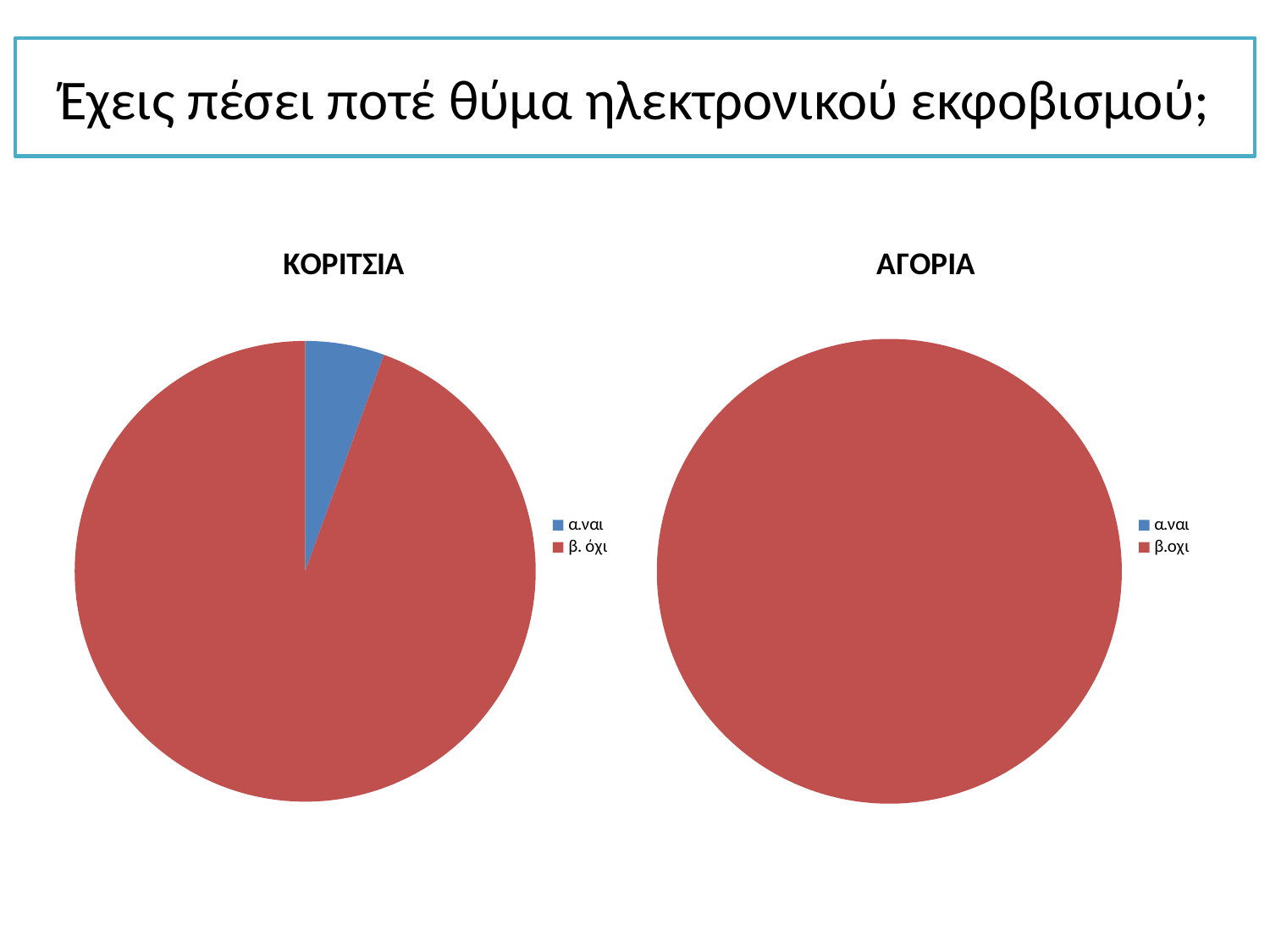
Which chart shows a visible α.ναι slice, ΚΟΡΙΤΣΙΑ or ΑΓΟΡΙΑ? ΚΟΡΙΤΣΙΑ In the ΚΟΡΙΤΣΙΑ chart, which category has the smallest slice? α.ναι In the ΚΟΡΙΤΣΙΑ chart, which category has the largest slice? β. όχι What is the title of the chart on the left? ΚΟΡΙΤΣΙΑ In the ΑΓΟΡΙΑ chart, which is larger: α.ναι or β.οχι? β.οχι How many categories does the legend of the ΑΓΟΡΙΑ chart list? 2 What kind of chart is the ΚΟΡΙΤΣΙΑ chart? pie chart In the ΑΓΟΡΙΑ chart, which category has the largest slice? β.οχι In the ΚΟΡΙΤΣΙΑ chart, what colour is the α.ναι slice? blue How many categories does the legend of the ΚΟΡΙΤΣΙΑ chart list? 2 What kind of chart is the ΑΓΟΡΙΑ chart? pie chart In the ΚΟΡΙΤΣΙΑ chart, which is larger: α.ναι or β. όχι? β. όχι